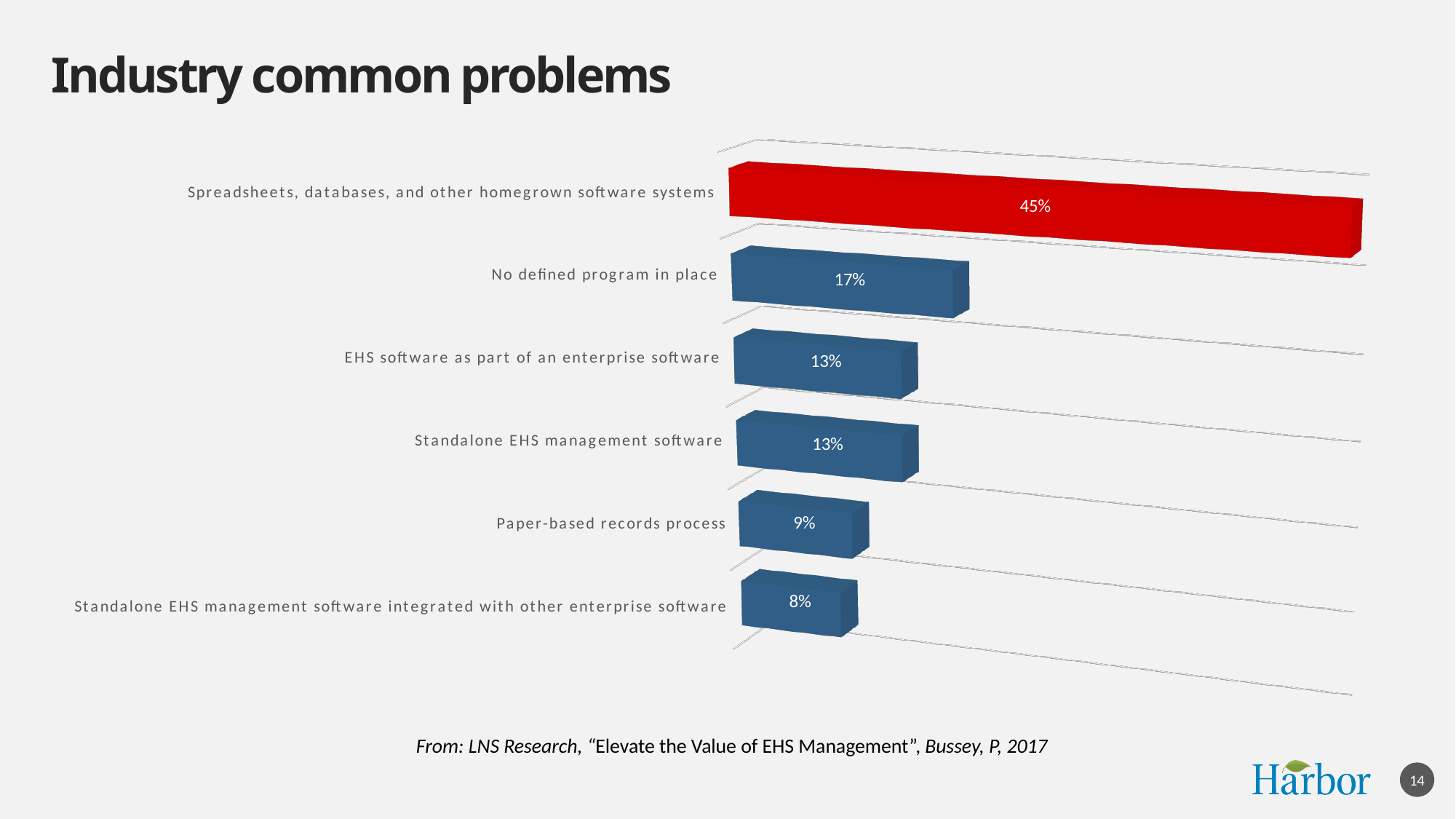
How many categories are shown in the chart? 6 Which category has the highest value? Spreadsheets, databases, and other homegrown software systems What is the difference between the values for Spreadsheets, databases, and other homegrown software systems and No defined program in place? 28% What is the difference between the values for Paper-based records process and Standalone EHS management software integrated with other enterprise software? 1% What is the value for Spreadsheets, databases, and other homegrown software systems? 45% What kind of chart is shown on the slide? Bar chart Which is larger, the value for No defined program in place or the value for EHS software as part of an enterprise software? No defined program in place What is the value for No defined program in place? 17% What is the value for Standalone EHS management software integrated with other enterprise software? 8% Which bar is coloured red rather than blue? Spreadsheets, databases, and other homegrown software systems What is the value for Paper-based records process? 9% Which category has the lowest value? Standalone EHS management software integrated with other enterprise software